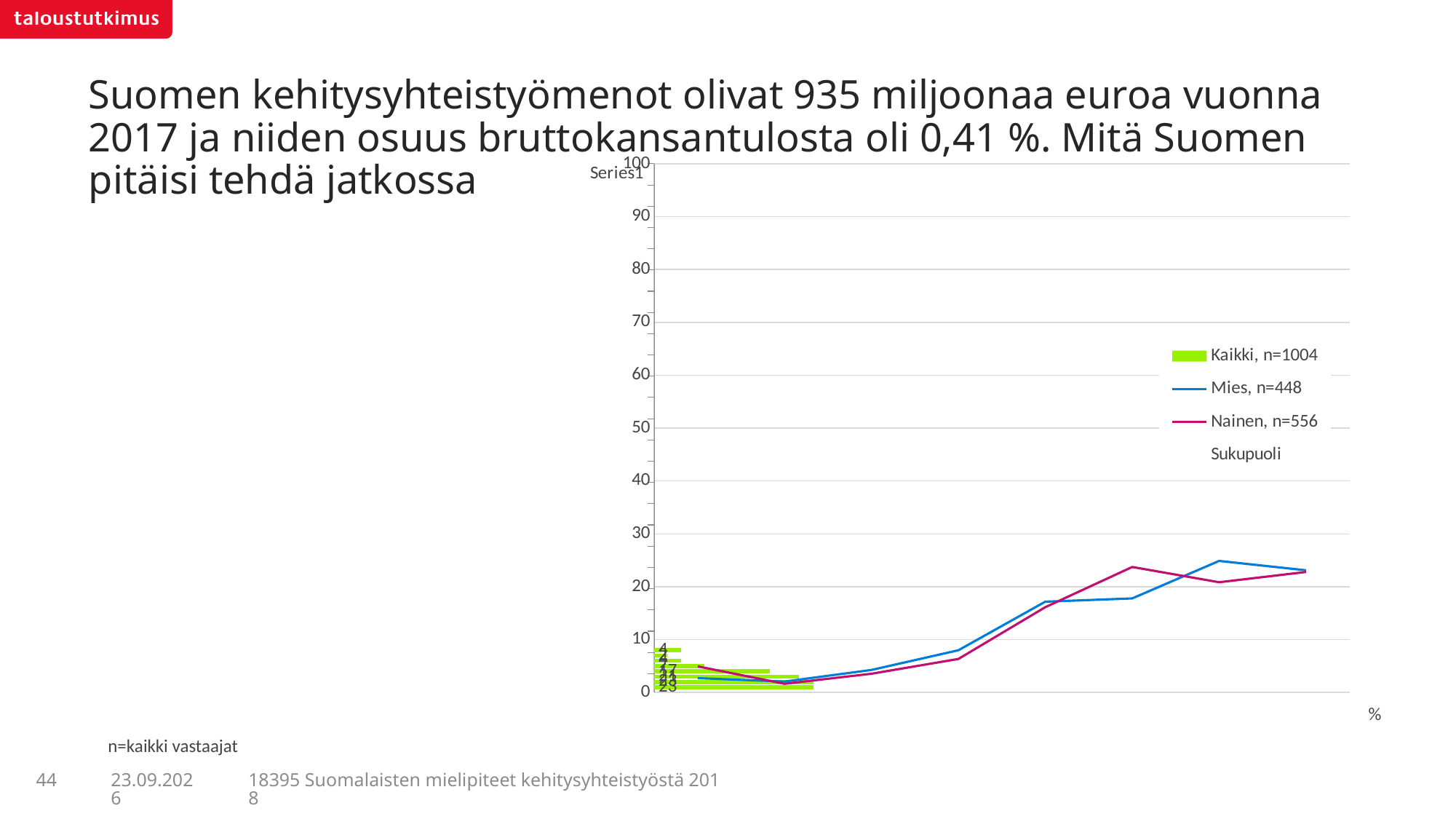
Is the highest point of the Mies line greater or less than 30? less What sample size does the legend give for the Nainen series? n=556 Which series is shown in green in the chart legend? Kaikki, n=1004 Is the lowest point of the Mies line greater or less than 10? less Is the highest point of the Nainen line greater or less than 20? greater How many series does the chart legend list? 4